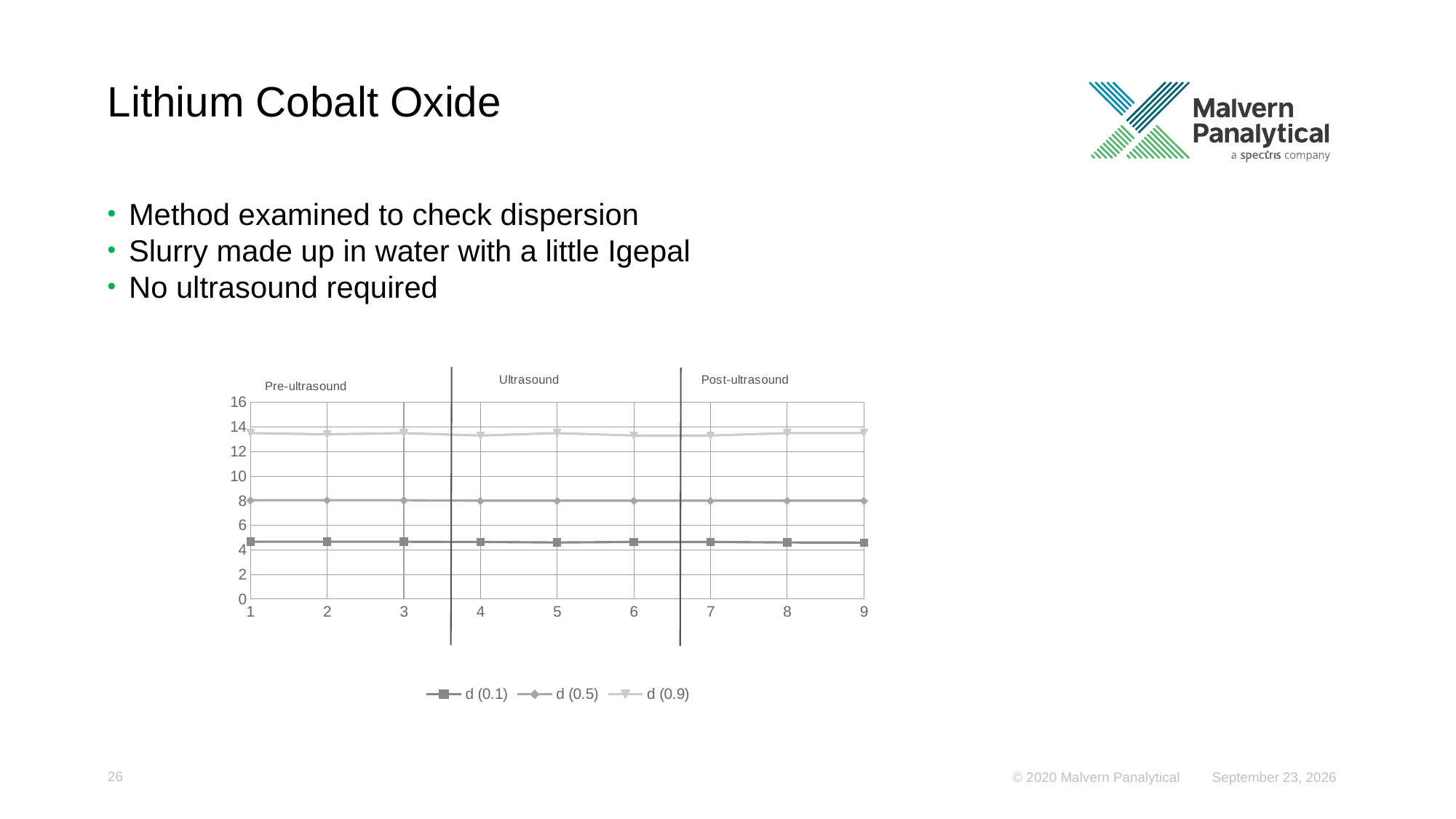
Is the value for d (0.5) at x = 3 greater or less than 10? less Do the values for d (0.9) rise, fall, or stay roughly constant from x = 1 to x = 9? Stay roughly constant What are the three section labels written above the chart? Pre-ultrasound, Ultrasound, Post-ultrasound How many points are plotted along the x axis for each series? 9 How many series does the chart legend list? 3 Is the value for d (0.1) at x = 5 greater or less than 6? less Which series has the highest values across the chart? d (0.9) Is the value for d (0.5) at x = 7 greater or less than 6? greater What kind of chart is shown on the slide? Line chart At x = 4, which series has the larger value, d (0.5) or d (0.1)? d (0.5) Which series has the lowest values across the chart? d (0.1)